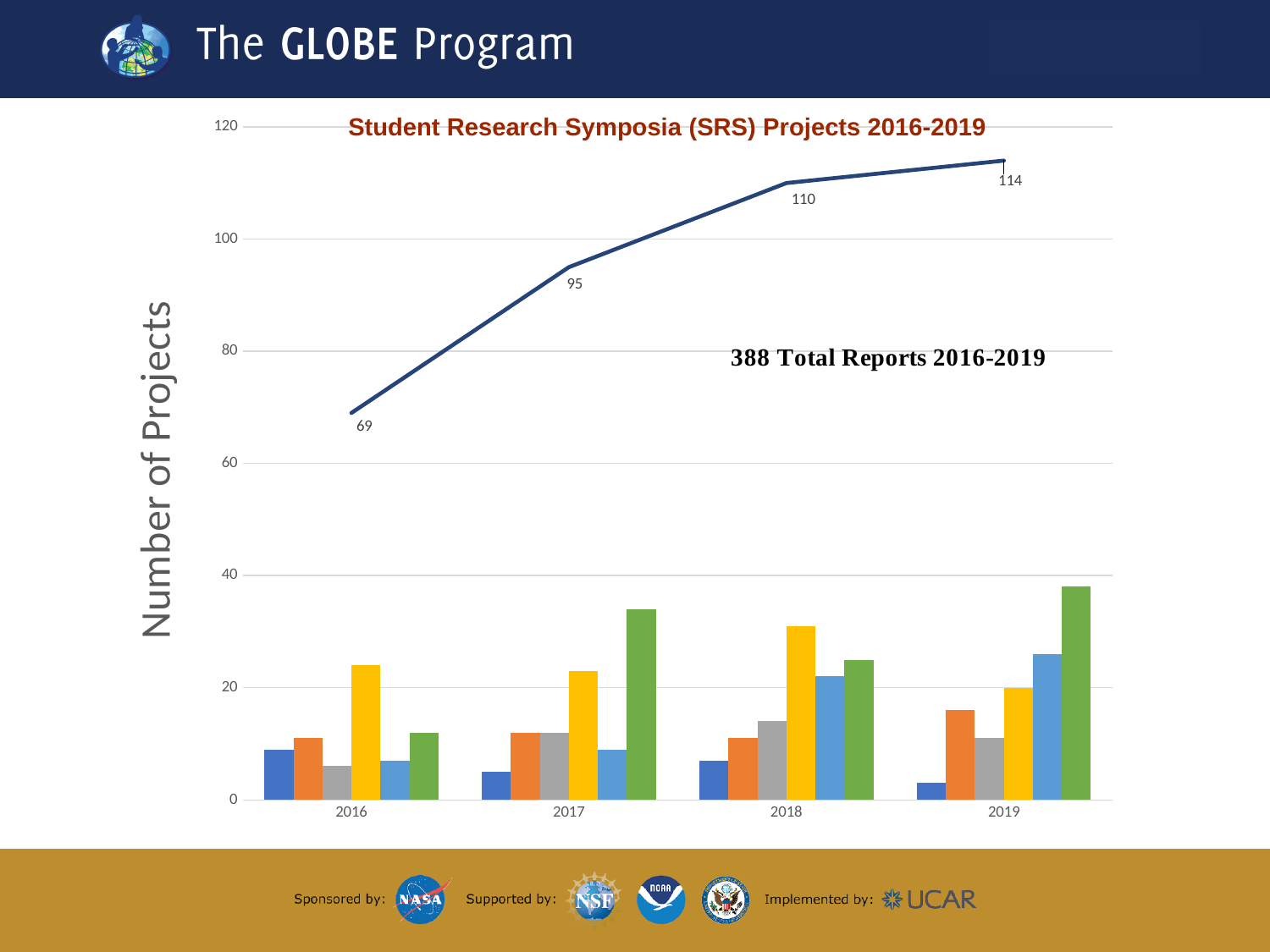
What kind of chart is shown on the slide? A combination of a line chart and a bar chart According to the line, how many projects were there in 2018? 110 Which year has the highest value on the line? 2019 Which year has the lowest value on the line? 2016 By how much did the line value increase from 2016 to 2019? 45 What is the label on the vertical axis of the chart? Number of Projects According to the line, how many projects were there in 2019? 114 How many years are shown on the x axis? 4 According to the line, how many projects were there in 2017? 95 According to the line, how many projects were there in 2016? 69 Does the line rise or fall from 2016 to 2019? Rise What is the title of the chart? Student Research Symposia (SRS) Projects 2016-2019